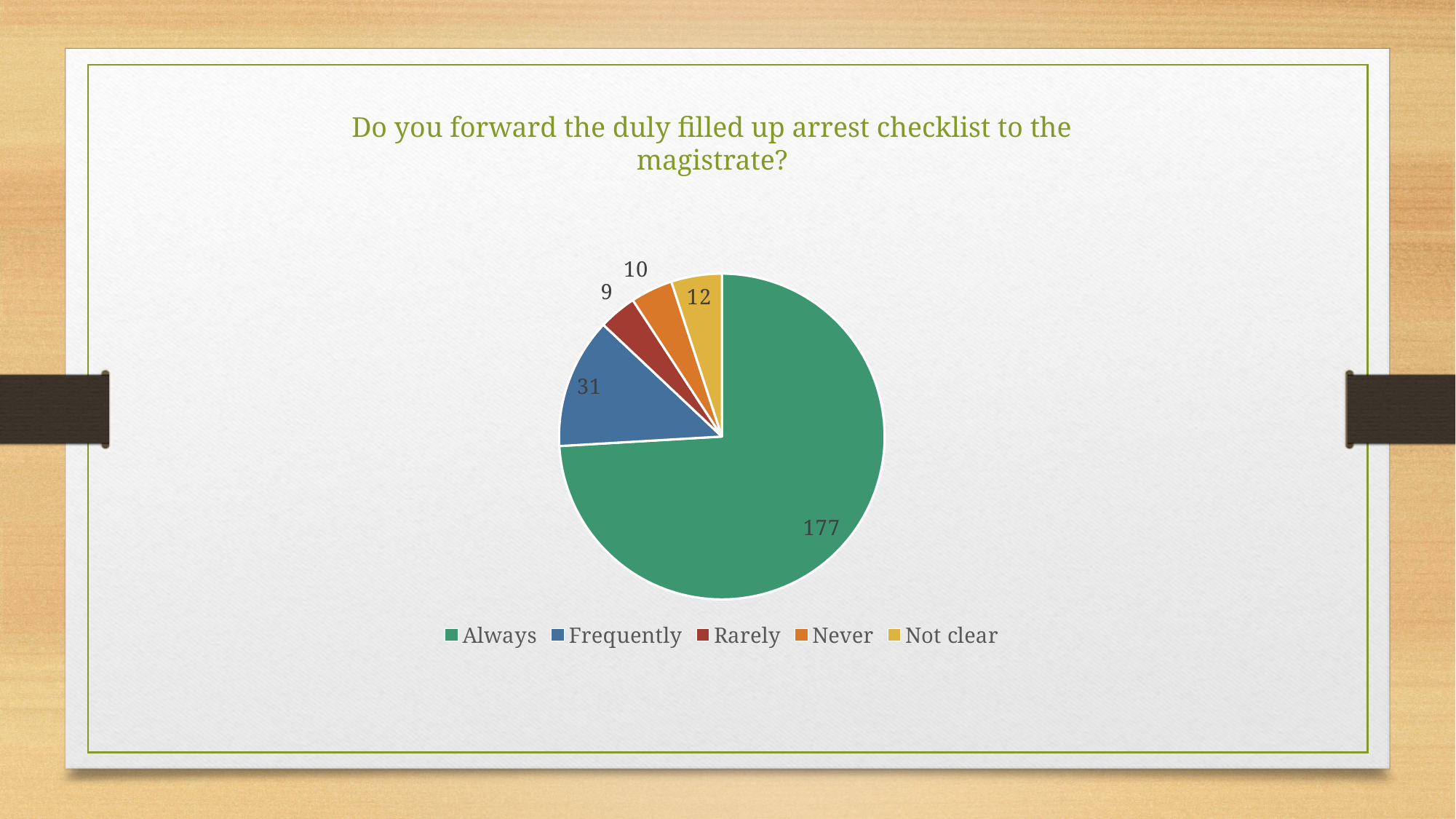
What is the title of the chart? Do you forward the duly filled up arrest checklist to the magistrate? How many categories does the pie chart show? 5 What is the value for Always? 177 What is the value for Never? 10 What kind of chart is shown on the slide? Pie chart Which category has the smallest slice? Rarely What is the value for Frequently? 31 Which is larger, the value for Not clear or the value for Never? Not clear Which category has the largest slice? Always What is the value for Not clear? 12 What is the total of all slices in the pie chart? 239 What is the difference between the values for Always and Frequently? 146